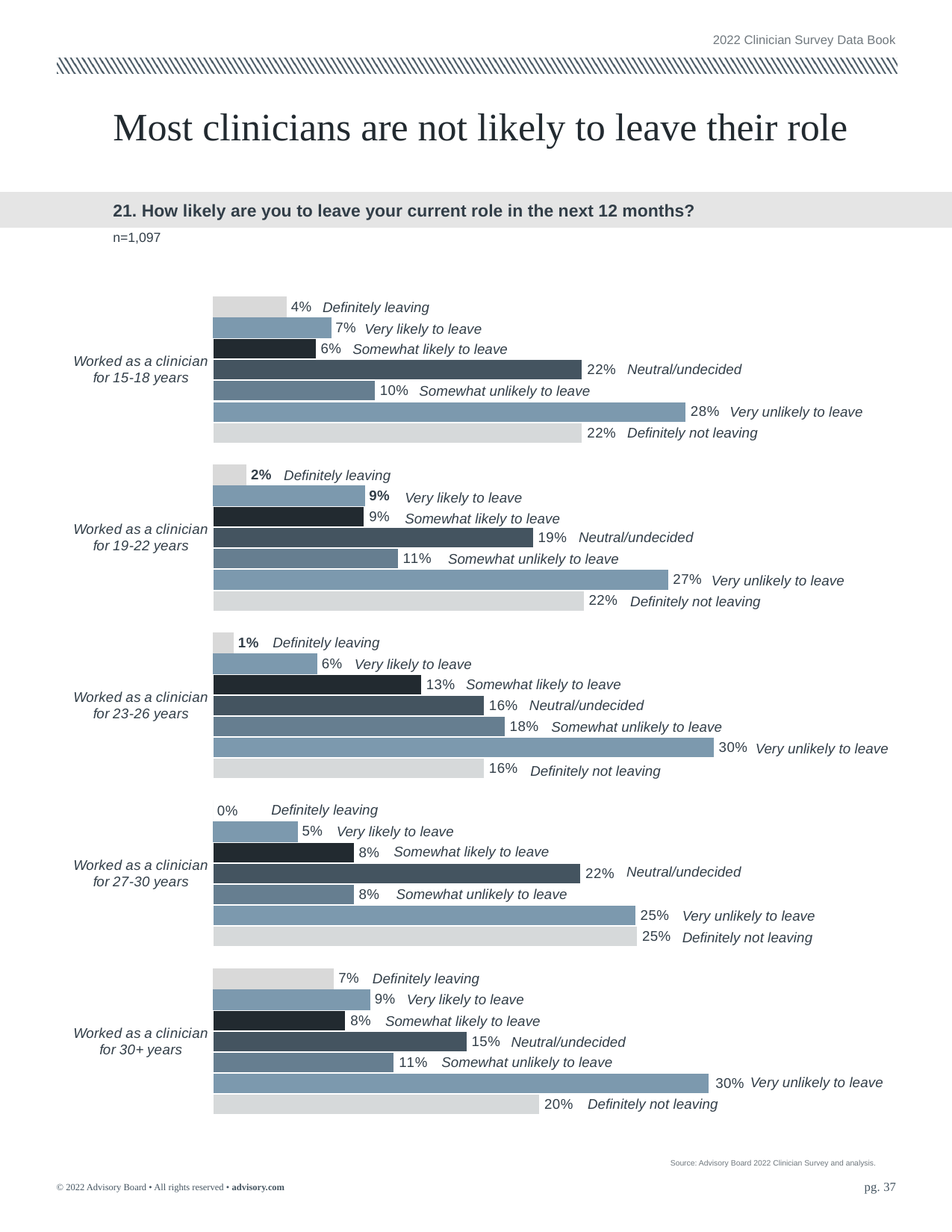
In the chart for clinicians who worked 30+ years, which is larger: 'Very likely to leave' or 'Somewhat likely to leave'? Very likely to leave In the chart for clinicians who worked 15-18 years, what is the difference between 'Very unlikely to leave' and 'Definitely not leaving'? 6% In the chart for clinicians who worked 23-26 years, what percentage are 'Somewhat likely to leave'? 13% In the chart for clinicians who worked 15-18 years, what percentage are 'Very unlikely to leave'? 28% In the chart for clinicians who worked 23-26 years, what is the difference between 'Somewhat unlikely to leave' and 'Neutral/undecided'? 2% In the chart for clinicians who worked 19-22 years, which response has the highest percentage? Very unlikely to leave What is the survey question shown above the charts? How likely are you to leave your current role in the next 12 months? In the chart for clinicians who worked 30+ years, what percentage are 'Neutral/undecided'? 15% In the chart for clinicians who worked 27-30 years, what percentage are 'Definitely leaving'? 0% What type of chart is used on this slide? Bar chart In the chart for clinicians who worked 30+ years, which response has the lowest percentage? Definitely leaving How many response categories are shown in the chart for clinicians who worked 27-30 years? 7